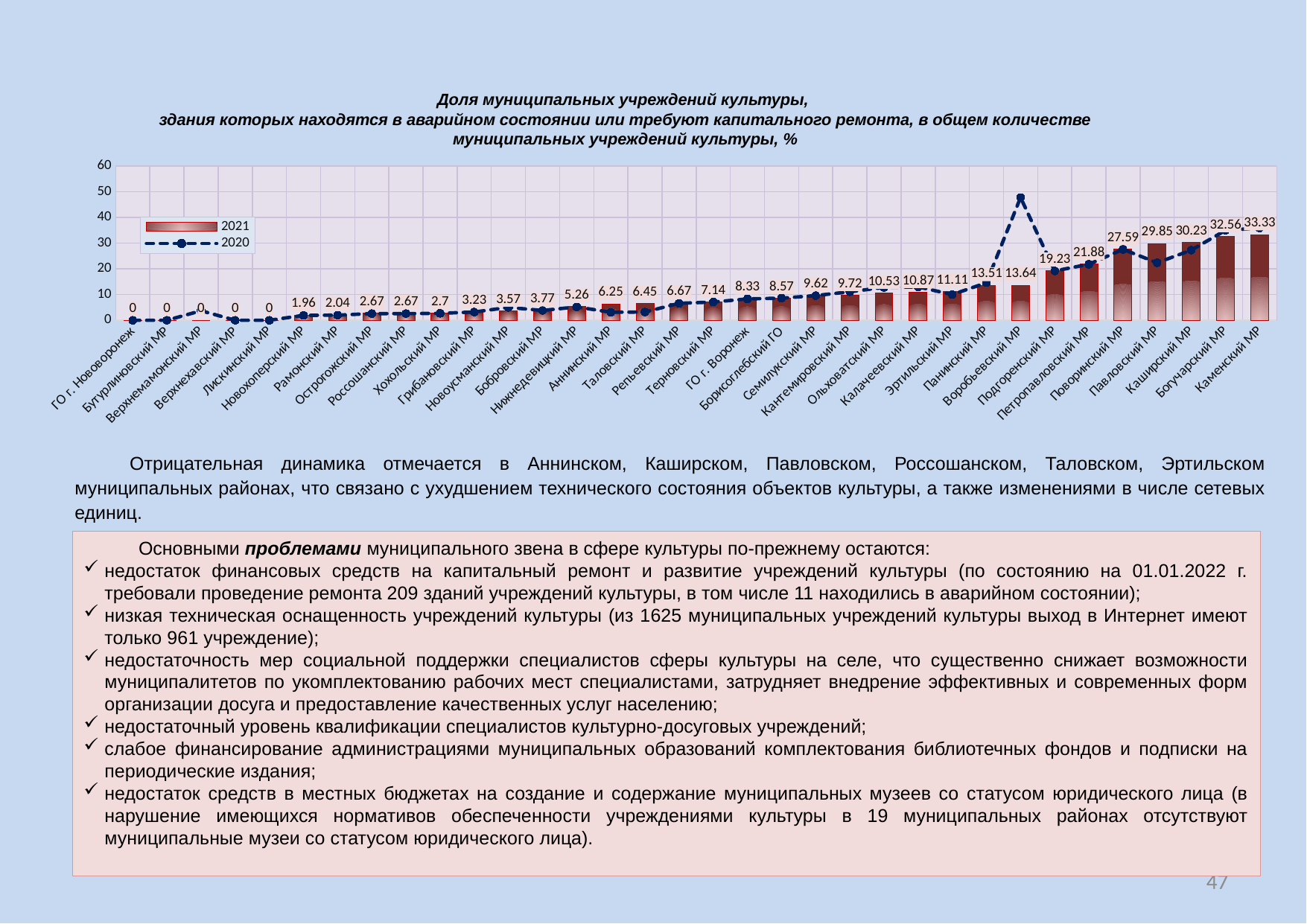
Is the 2020 value for Воробьевский МР greater or less than 40? greater What is the difference between the 2021 values for Петропавловский МР and Подгоренский МР? 2.65 Which category has the highest 2021 value? Каменский МР Which series is shown as a dashed line? 2020 Which has a larger 2021 value, Поворинский МР or Павловский МР? Павловский МР How many categories are shown on the x axis? 34 What kind of chart is this? Combined bar and line chart How many series does the legend list? 2 What is the 2021 value for Подгоренский МР? 19.23 Do the 2021 bar values rise or fall from left to right along the x axis? rise What is the 2021 value for Каменский МР? 33.33 What is the 2021 value for Нижнедевицкий МР? 5.26